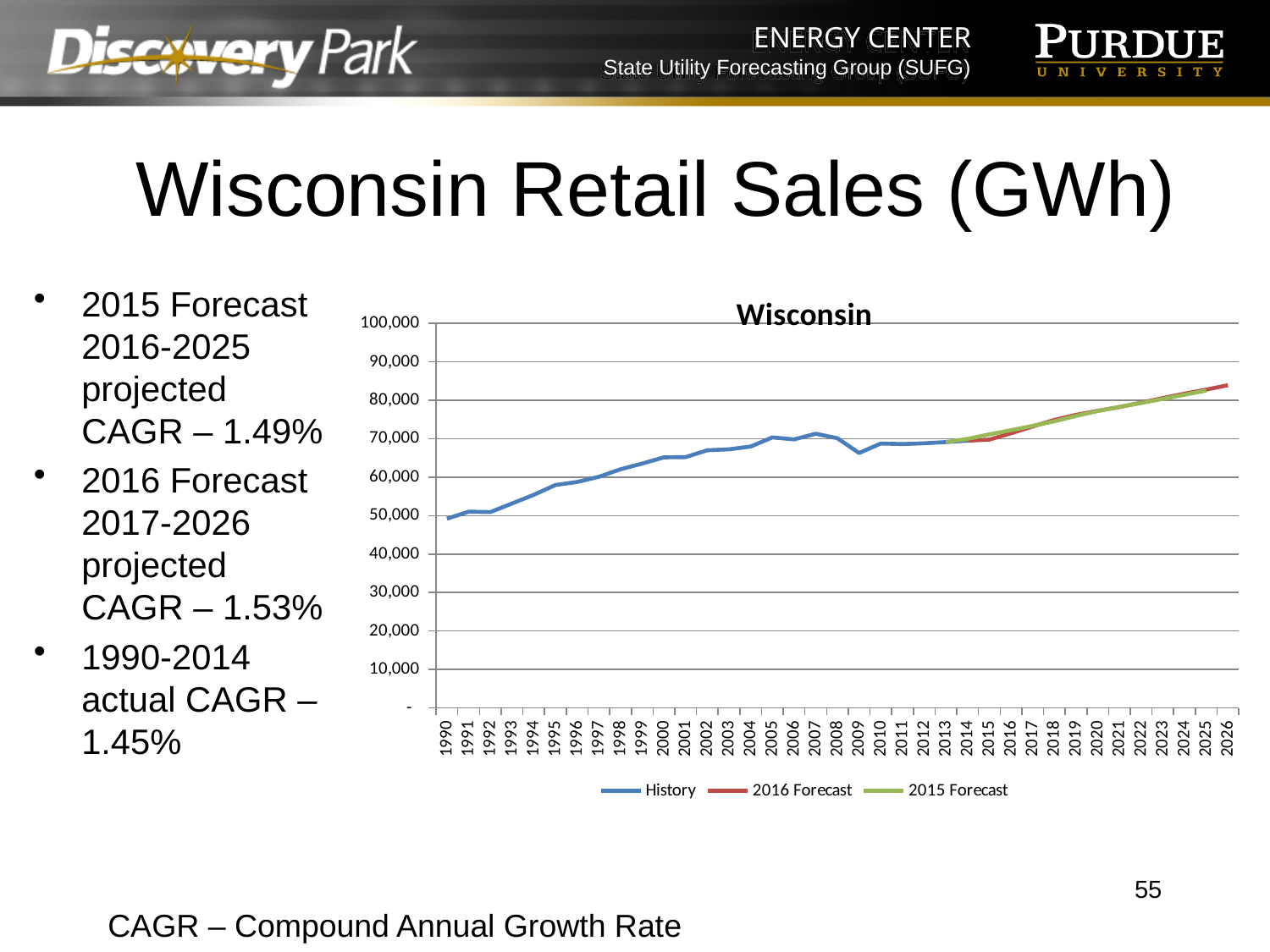
What is the title of the chart? Wisconsin Which series are listed in the chart legend? History, 2016 Forecast, 2015 Forecast Is the History value for 2009 greater or less than 70,000? less Which year has a higher History value, 2007 or 2009? 2007 Is the 2016 Forecast value for 2026 greater or less than 80,000? greater Is the History value for 2005 greater or less than 60,000? greater Which year has the lowest History value? 1990 What kind of chart is shown on the slide? line chart Do the History values generally rise or fall from 1990 to 2014? rise How many years are labelled on the x axis? 37 How many series does the chart legend list? 3